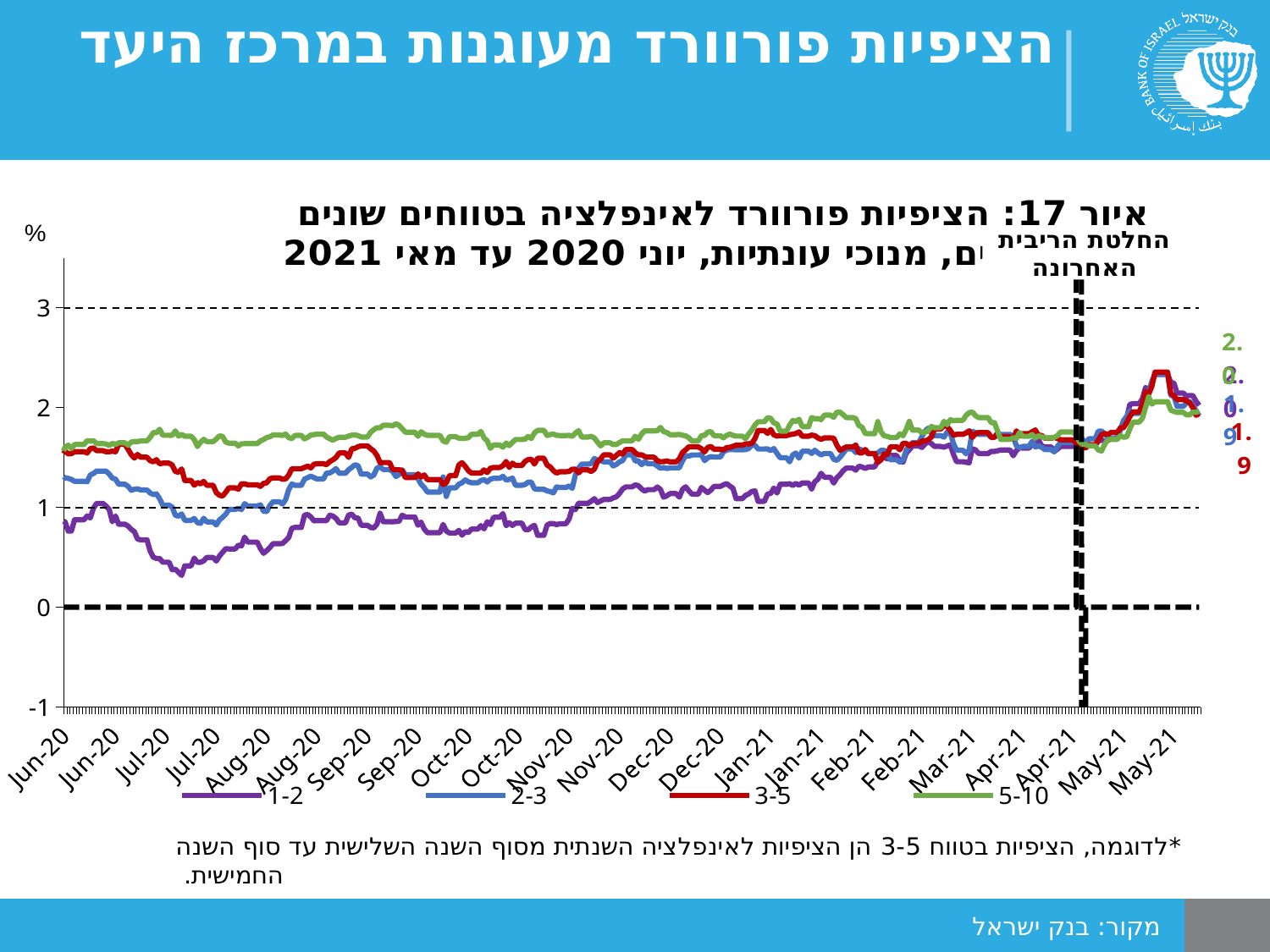
What kind of chart is shown on the slide? Line chart Does any series reach a value greater than 3 at any point in the chart? No Is the value of the 1-2 series at the end of the period (May-21) greater or less than 1? greater What are the four series listed in the legend? 1-2, 2-3, 3-5, 5-10 Is the value of the 5-10 series around Aug-20 greater or less than 1? greater Around Jul-20, which series is higher: 5-10 or 1-2? 5-10 Which series has the lowest value around Jul-20? 1-2 Which series has the highest value around Aug-20? 5-10 Does the 1-2 series rise or fall overall from Jun-20 to May-21? Rise How many series does the legend list? 4 What unit is shown on the y axis? %